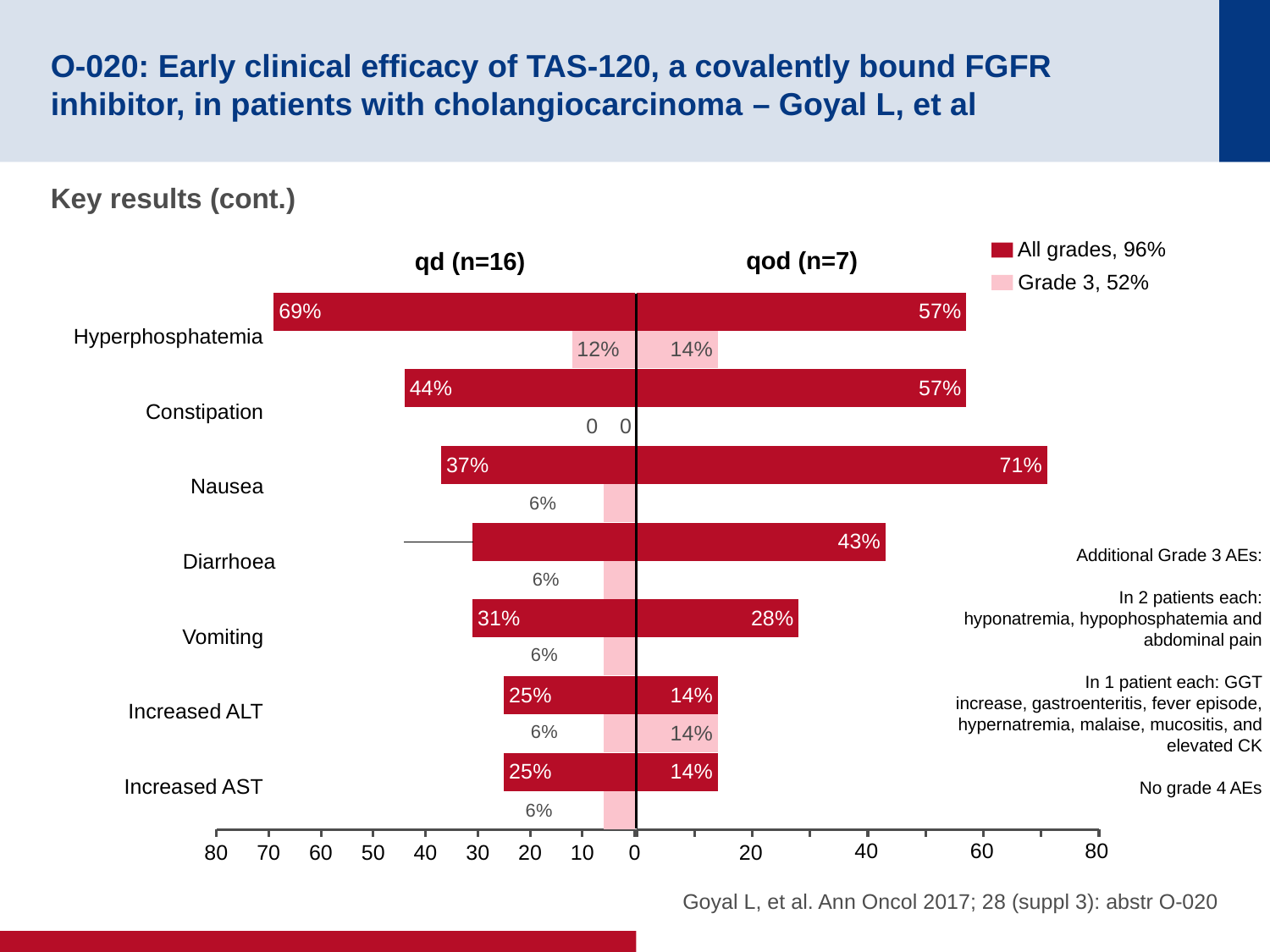
Which adverse event has the highest all-grades rate in the qd (n=16) group? Hyperphosphatemia What overall percentage is given for Grade 3 events in the legend? 52% Which group has the higher all-grades rate of constipation, qd or qod? qod How many series does the legend list? 2 What kind of chart is shown on the slide? Bar chart What is the difference between the all-grades rates of hyperphosphatemia in the qd and qod groups? 12 percentage points What is the all-grades rate of nausea in the qod (n=7) group? 71% How many adverse event categories are shown on the chart? 7 Which adverse event has the highest all-grades rate in the qod (n=7) group? Nausea What is the all-grades rate of hyperphosphatemia in the qd (n=16) group? 69% What is the Grade 3 rate of hyperphosphatemia in the qod (n=7) group? 14% Is the all-grades rate of diarrhoea in the qd (n=16) group greater or less than 40? less